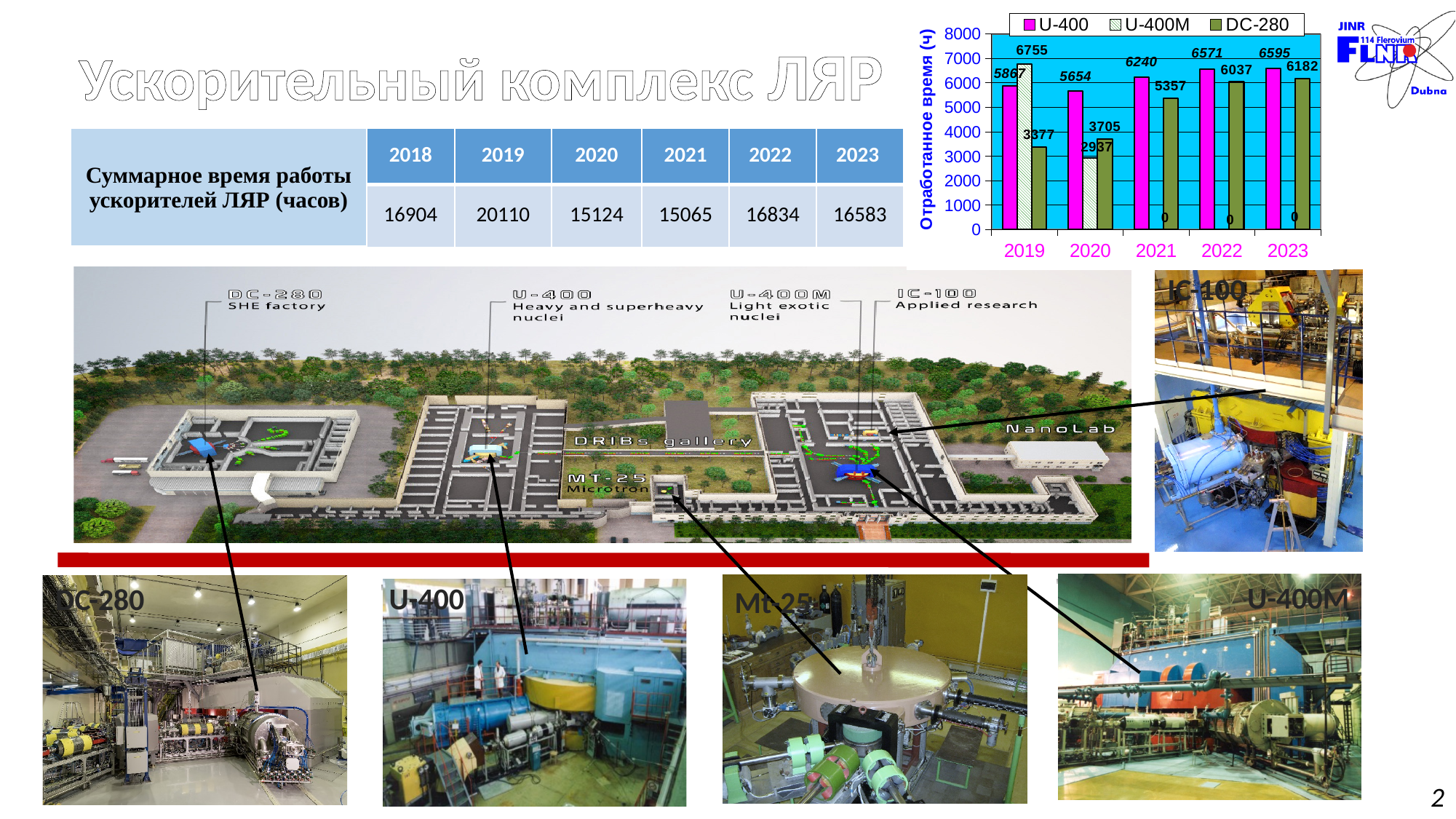
How many series does the legend of the bar chart list? 3 What is the value for U-400M in 2019 in the bar chart? 6755 In which year is the DC-280 value lowest in the bar chart? 2019 Does the DC-280 value rise or fall from 2019 to 2023 in the bar chart? rise How many years are shown on the x axis of the bar chart? 5 What is the difference between the U-400 and DC-280 values in 2022 in the bar chart? 534 What is the value for DC-280 in 2020 in the bar chart? 3705 What is the y-axis label of the bar chart? Отработанное время (ч) In 2020, which is larger in the bar chart: U-400 or U-400M? U-400 What is the value for U-400M in 2021 in the bar chart? 0 What is the value for U-400 in 2019 in the bar chart? 5867 In which year is the U-400 value highest in the bar chart? 2023